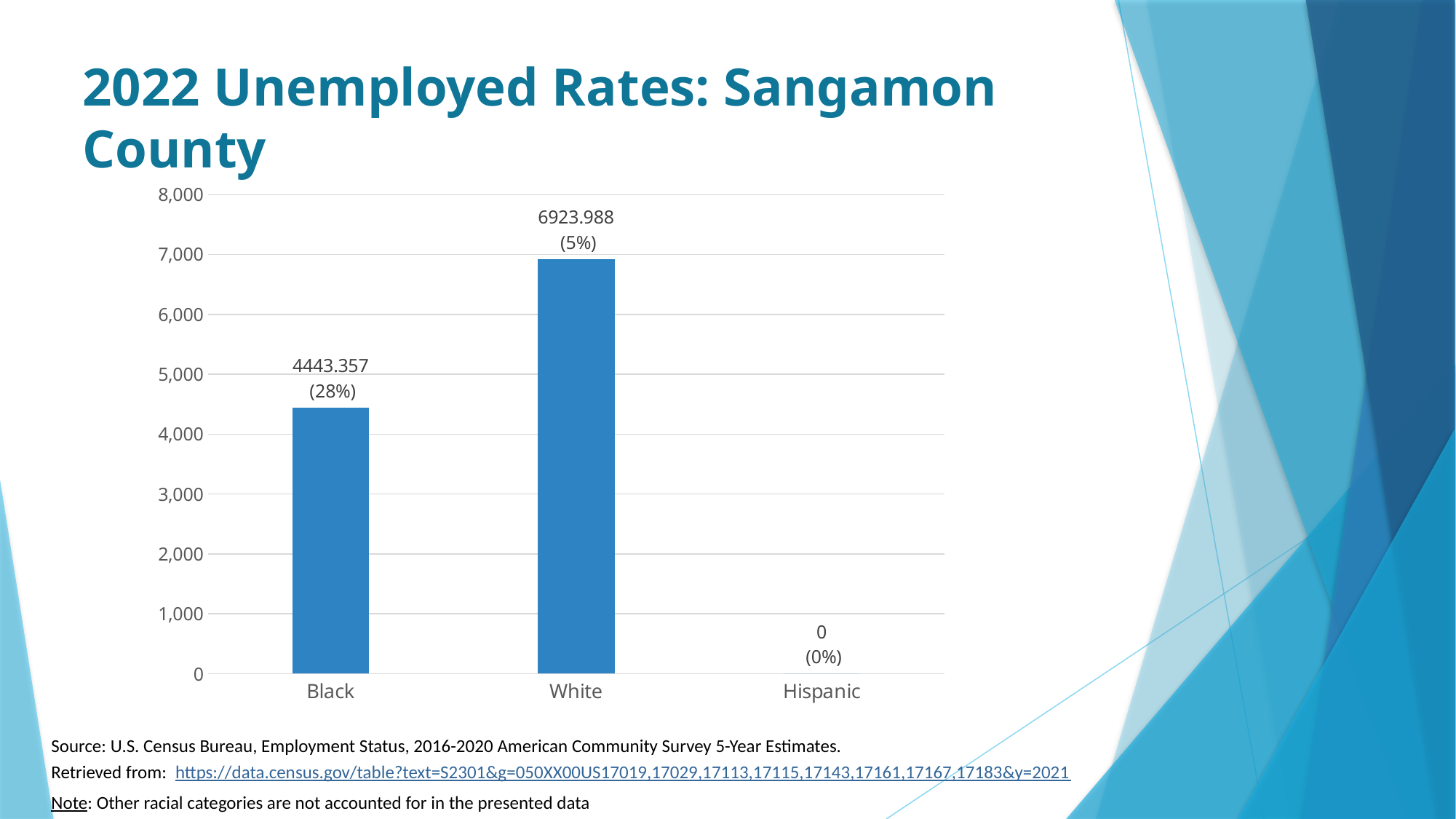
How many categories are shown on the x axis? 3 What value is shown for the White category? 6923.988 What percentage is shown in parentheses for the Black category? 28% Which category has the highest value? White What is the difference between the values for White and Black? 2480.631 What percentage is shown in parentheses for the White category? 5% What kind of chart is shown on the slide? bar chart Which is larger, the value for Black or the value for White? White What value is shown for the Hispanic category? 0 Which category has the lowest value? Hispanic Is the value for Black greater or less than 4,000? greater What value is shown for the Black category? 4443.357